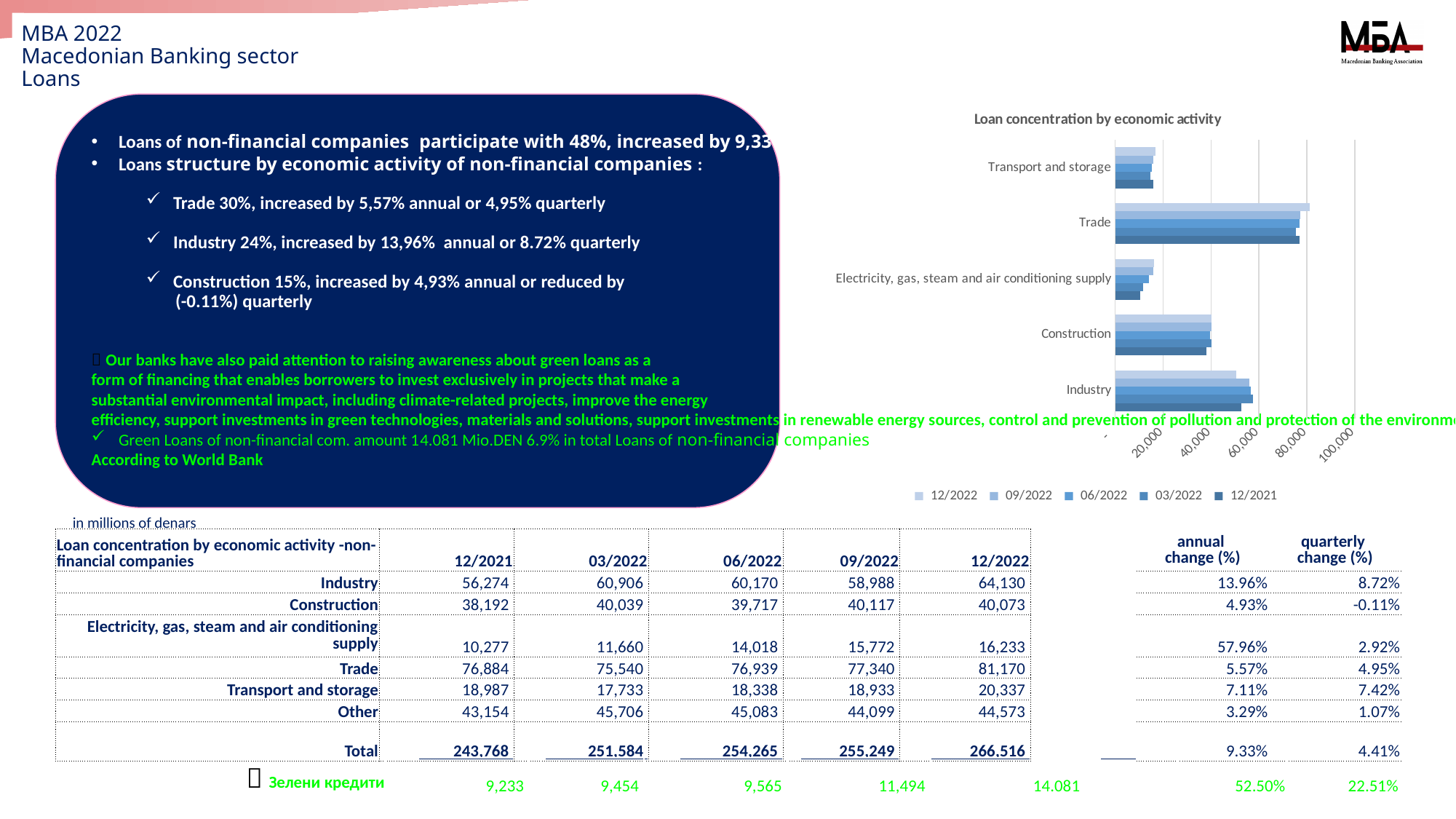
What is the difference between the 12/2022 loan values for Industry and Construction? 24,057 Which economic activity has the highest loan values in the chart? Trade Is the 12/2022 value for Electricity, gas, steam and air conditioning supply greater or less than 20,000? less Is the 12/2022 value for Construction greater or less than 60,000? less What is the title of the chart on the slide? Loan concentration by economic activity Is the 12/2022 value for Transport and storage greater or less than 40,000? less How many series does the chart legend list? 5 How many economic activity categories are plotted in the chart? 5 What kind of chart is shown on the slide? bar chart What is the 12/2022 loan value for Trade? 81,170 Which economic activity has the lowest loan values in the chart? Electricity, gas, steam and air conditioning supply In 12/2022, which is larger: the loan value for Industry or for Construction? Industry